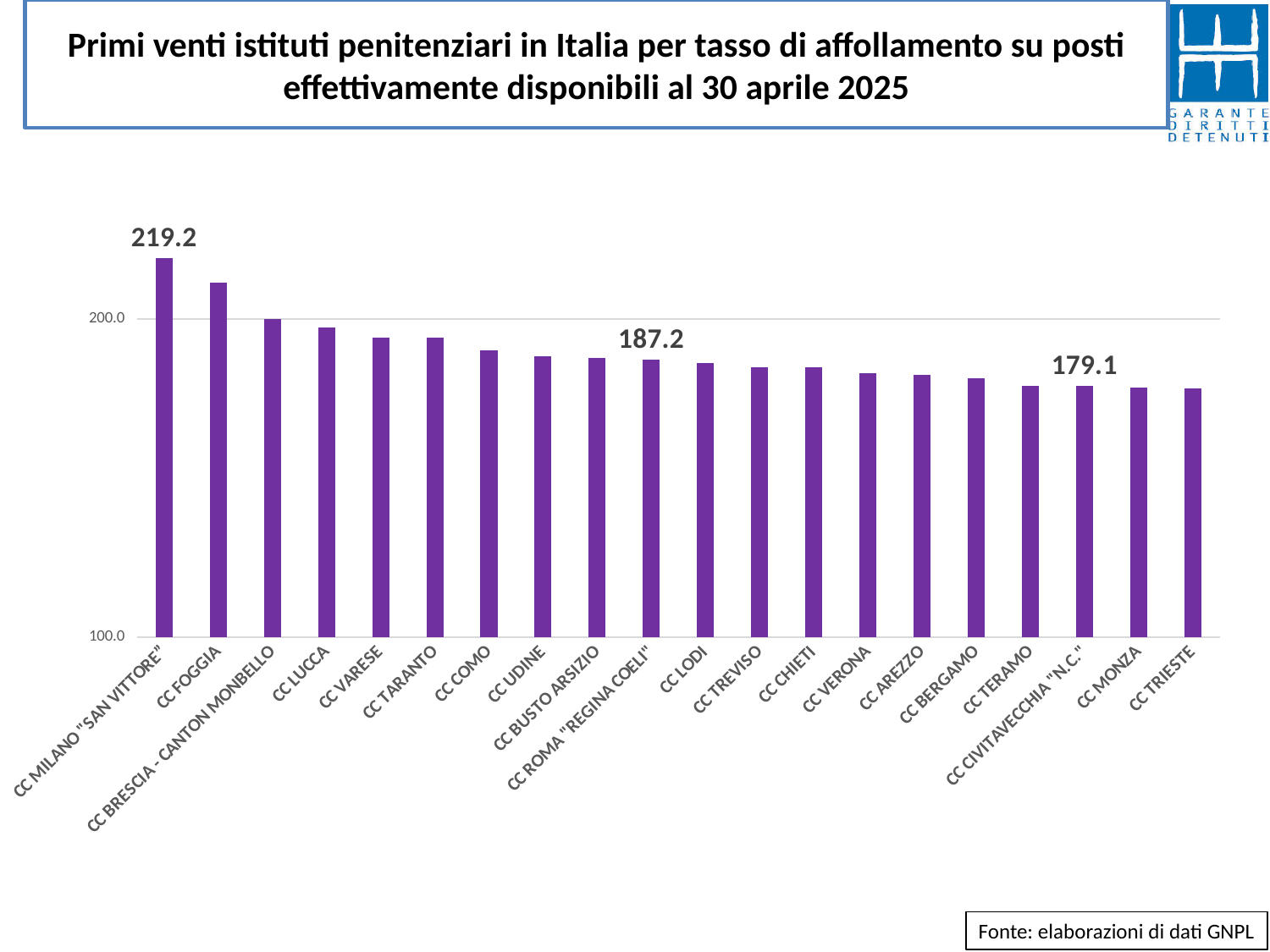
Which is larger, the value for CC MILANO "SAN VITTORE" or the value for CC CIVITAVECCHIA "N.C."? CC MILANO "SAN VITTORE" What is the value for CC CIVITAVECCHIA "N.C."? 179.1 How many institutes are shown in the chart? 20 Is the value for CC LUCCA greater or less than 200.0? less Do the values rise or fall from left to right along the x axis? fall What kind of chart is shown on the slide? bar chart Is the value for CC FOGGIA greater or less than 200.0? greater What is the difference between the values for CC ROMA "REGINA COELI" and CC CIVITAVECCHIA "N.C."? 28.1 What is the value for CC MILANO "SAN VITTORE"? 219.2 What is the value for CC ROMA "REGINA COELI"? 187.2 What is the difference between the values for CC MILANO "SAN VITTORE" and CC ROMA "REGINA COELI"? 32.0 Which institute has the highest value in the chart? CC MILANO "SAN VITTORE"